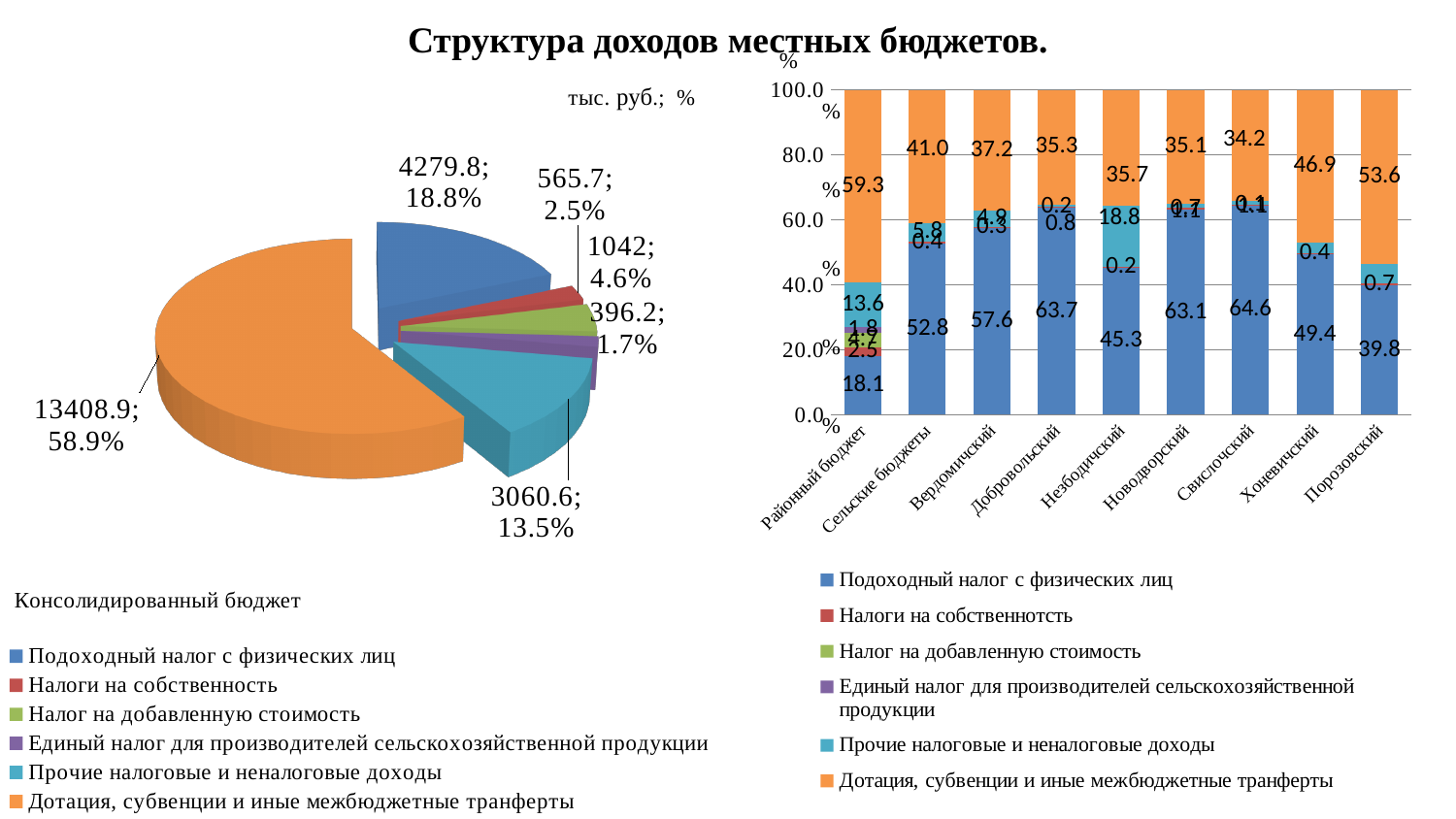
In the stacked bar chart on the right, which category has the highest value for Подоходный налог с физических лиц? Свислочский In the stacked bar chart on the right, how many categories are shown on the x axis? 9 In the stacked bar chart on the right, how many series does the legend list? 6 In the pie chart (Консолидированный бюджет), what value is shown for Прочие налоговые и неналоговые доходы? 3060.6; 13.5% In the pie chart (Консолидированный бюджет), what value is shown for Дотация, субвенции и иные межбюджетные трансферты? 13408.9; 58.9% In the stacked bar chart on the right, which category has the lowest value for Подоходный налог с физических лиц? Районный бюджет In the pie chart (Консолидированный бюджет), which category has the smallest slice? Единый налог для производителей сельскохозяйственной продукции In the stacked bar chart on the right, what is the value of Подоходный налог с физических лиц for Свислочский? 64.6 What type of chart is shown on the left side of the slide? Pie chart In the pie chart (Консолидированный бюджет), what share does Подоходный налог с физических лиц have? 18.8% In the stacked bar chart on the right, what is the value of Дотация, субвенции и иные межбюджетные трансферты for Порозовский? 53.6 In the stacked bar chart on the right, what is the difference between the Подоходный налог с физических лиц values for Добровольский and Незбодичский? 18.4